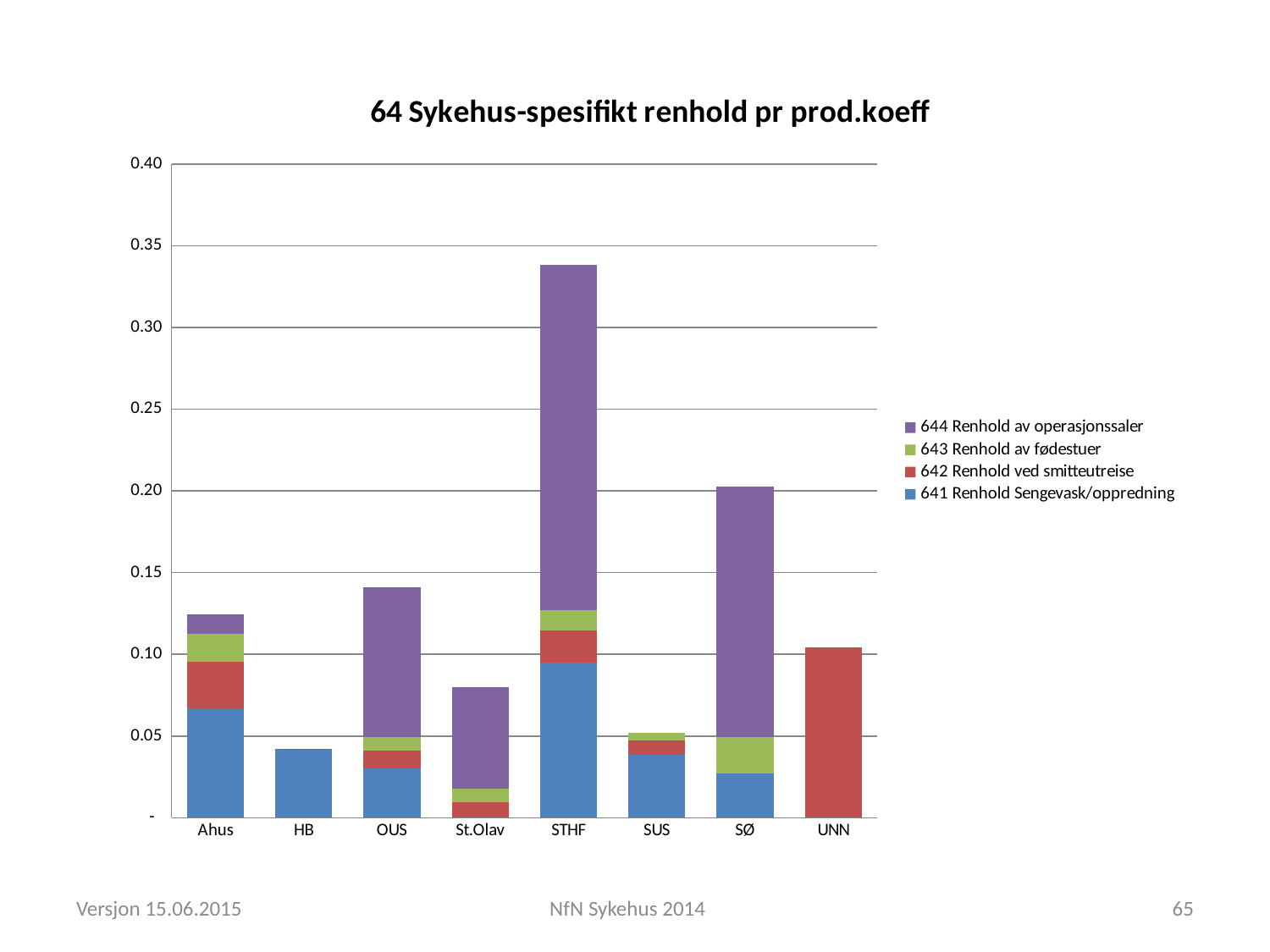
What kind of chart is shown on the slide? Stacked bar chart Is the total value for St.Olav greater or less than 0.10? less Which single series makes up the entire bar for UNN? 642 Renhold ved smitteutreise Is the total value for STHF greater or less than 0.30? greater Is the total value for SØ greater or less than 0.15? greater Which has the larger total bar, STHF or SØ? STHF What is the title of the chart? 64 Sykehus-spesifikt renhold pr prod.koeff Which hospital has the highest total stacked bar? STHF How many series does the legend list? 4 How many hospitals (categories) are shown on the x axis? 8 Which has the larger total bar, Ahus or St.Olav? Ahus